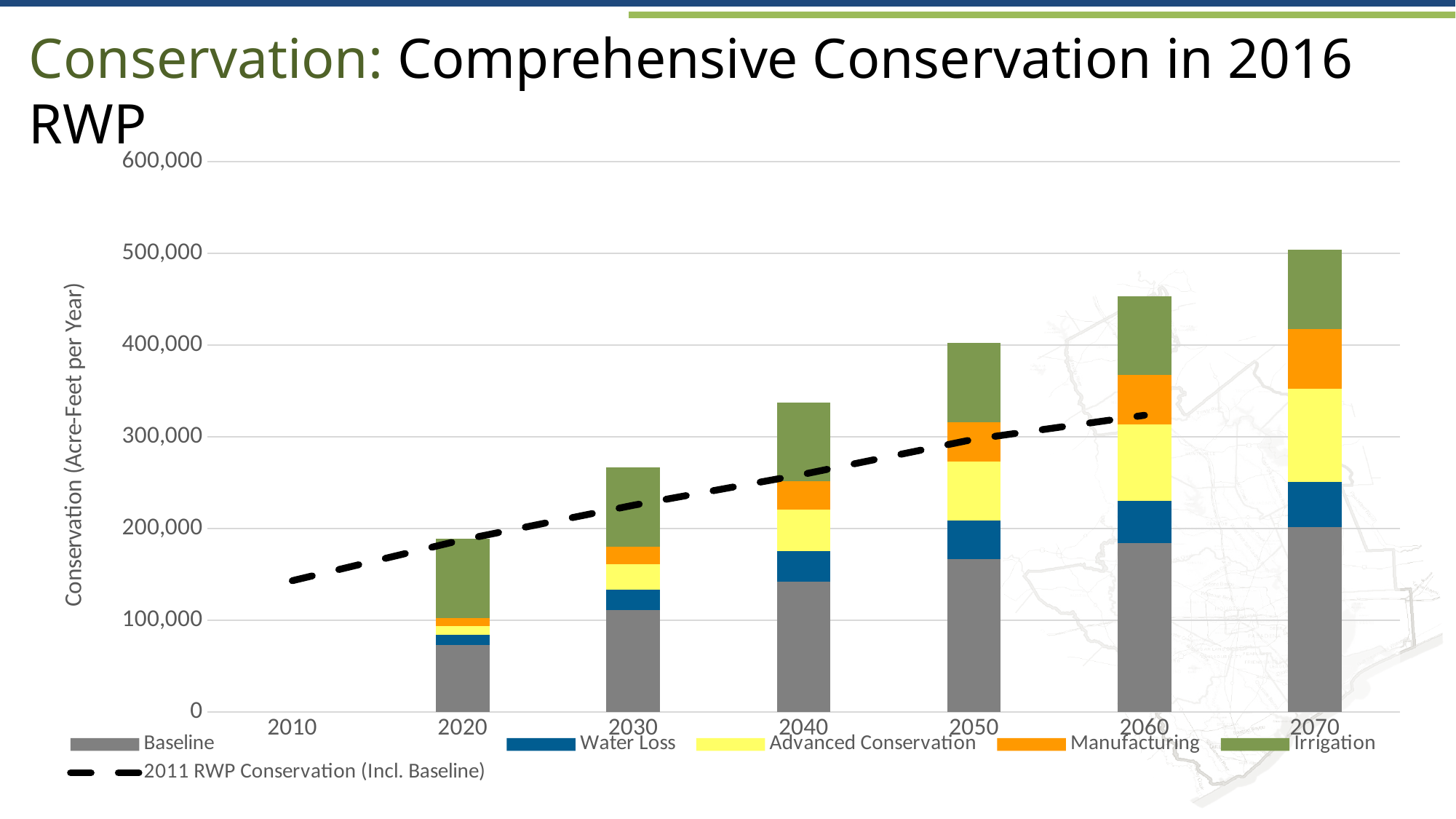
How many series does the legend list? 6 Is the total stacked bar value for 2020 greater or less than 200,000? less Is the total stacked bar value for 2060 greater or less than 400,000? greater What kind of chart is shown on the slide? Stacked bar chart with a dashed line Which year has the shortest stacked bar? 2020 Is the total stacked bar value for 2030 greater or less than 300,000? less What is the label on the vertical axis of the chart? Conservation (Acre-Feet per Year) How many stacked bars are plotted in the chart? 6 Which year has the tallest stacked bar? 2070 Do the stacked bar totals rise or fall from 2020 to 2070? Rise Which is larger, the Baseline segment for 2070 or the Baseline segment for 2020? 2070